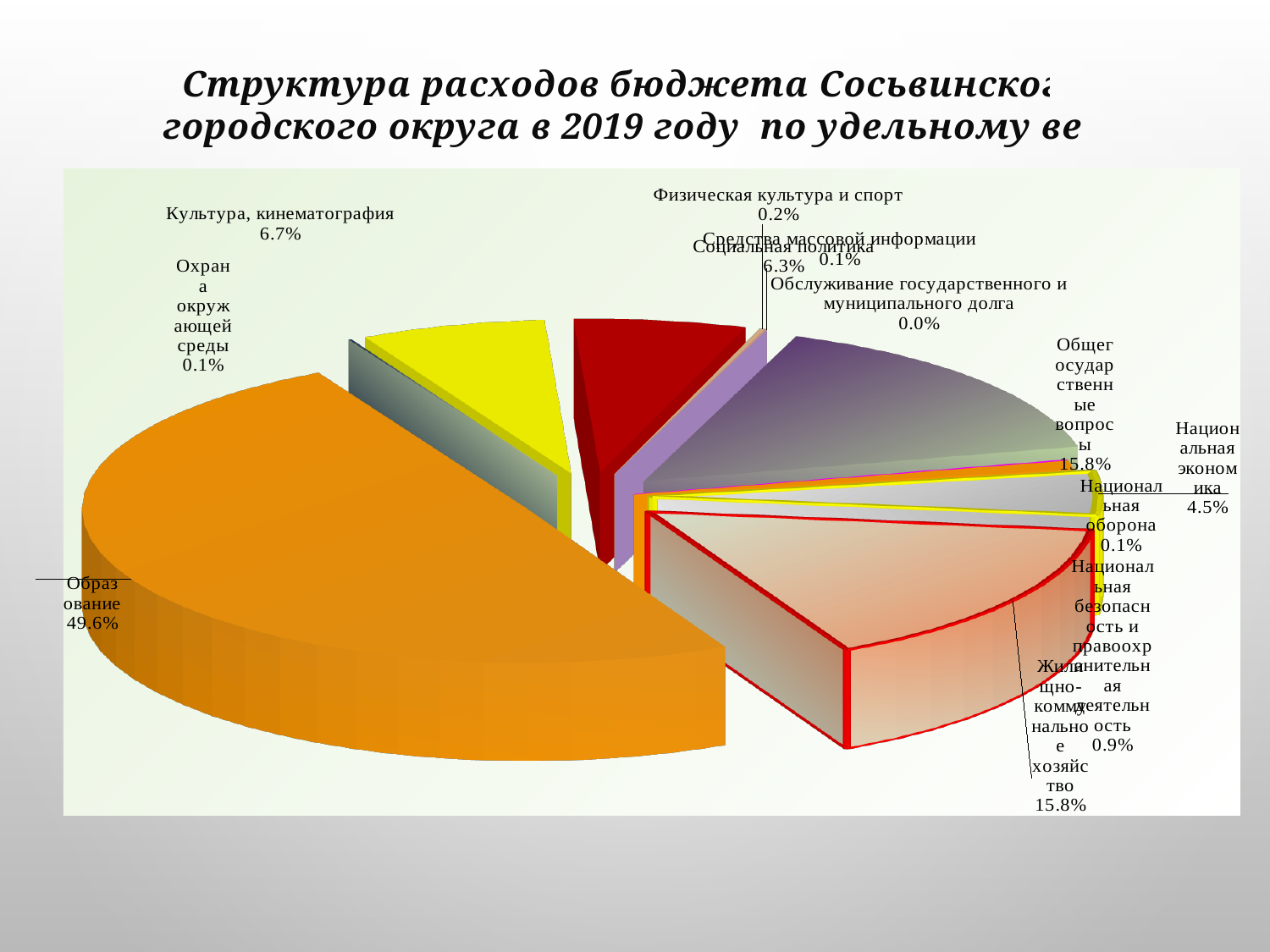
Which category has the smallest share of the pie? Обслуживание государственного и муниципального долга What is the difference between the shares of Образование and Общегосударственные вопросы? 33.8% What is the value shown for Общегосударственные вопросы? 15.8% What kind of chart is shown on the slide? pie chart Which category has the largest share of the pie? Образование Which is larger, the share for Культура, кинематография or the share for Национальная экономика? Культура, кинематография What is the value shown for Социальная политика? 6.3% What is the value shown for Жилищно-коммунальное хозяйство? 15.8% What share of budget expenditure does Образование account for? 49.6% How many categories are shown in the pie chart? 12 What is the value shown for Культура, кинематография? 6.7% What is the value shown for Национальная экономика? 4.5%